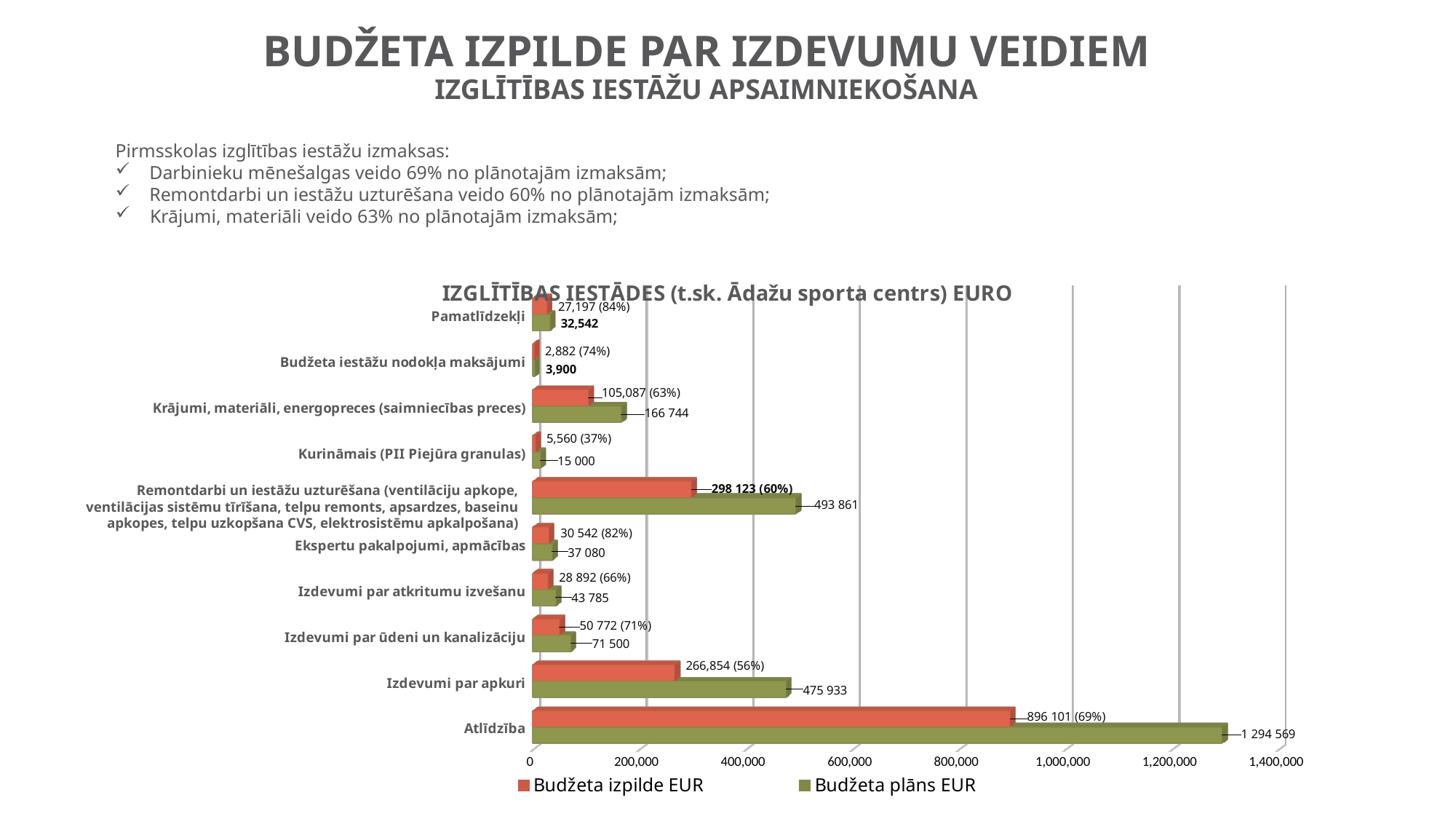
Which series is shown in red in the chart? Budžeta izpilde EUR Which category has the lowest Budžeta izpilde EUR value? Budžeta iestāžu nodokļa maksājumi What is the difference between the Budžeta plāns EUR and Budžeta izpilde EUR values for Izdevumi par apkuri? 209 079 What percentage of the plan is shown next to the Budžeta izpilde EUR value for Pamatlīdzekļi? 84% What is the Budžeta izpilde EUR value for Izdevumi par apkuri? 266,854 How many expense categories are plotted in the chart? 10 How many series does the chart legend list? 2 Which category has the highest Budžeta plāns EUR value? Atlīdzība What is the Budžeta plāns EUR value for Kurināmais (PII Piejūra granulas)? 15 000 What is the Budžeta plāns EUR value for Atlīdzība? 1 294 569 Which is larger for Remontdarbi un iestāžu uzturēšana: the Budžeta izpilde EUR value or the Budžeta plāns EUR value? Budžeta plāns EUR What type of chart is shown on the slide? bar chart